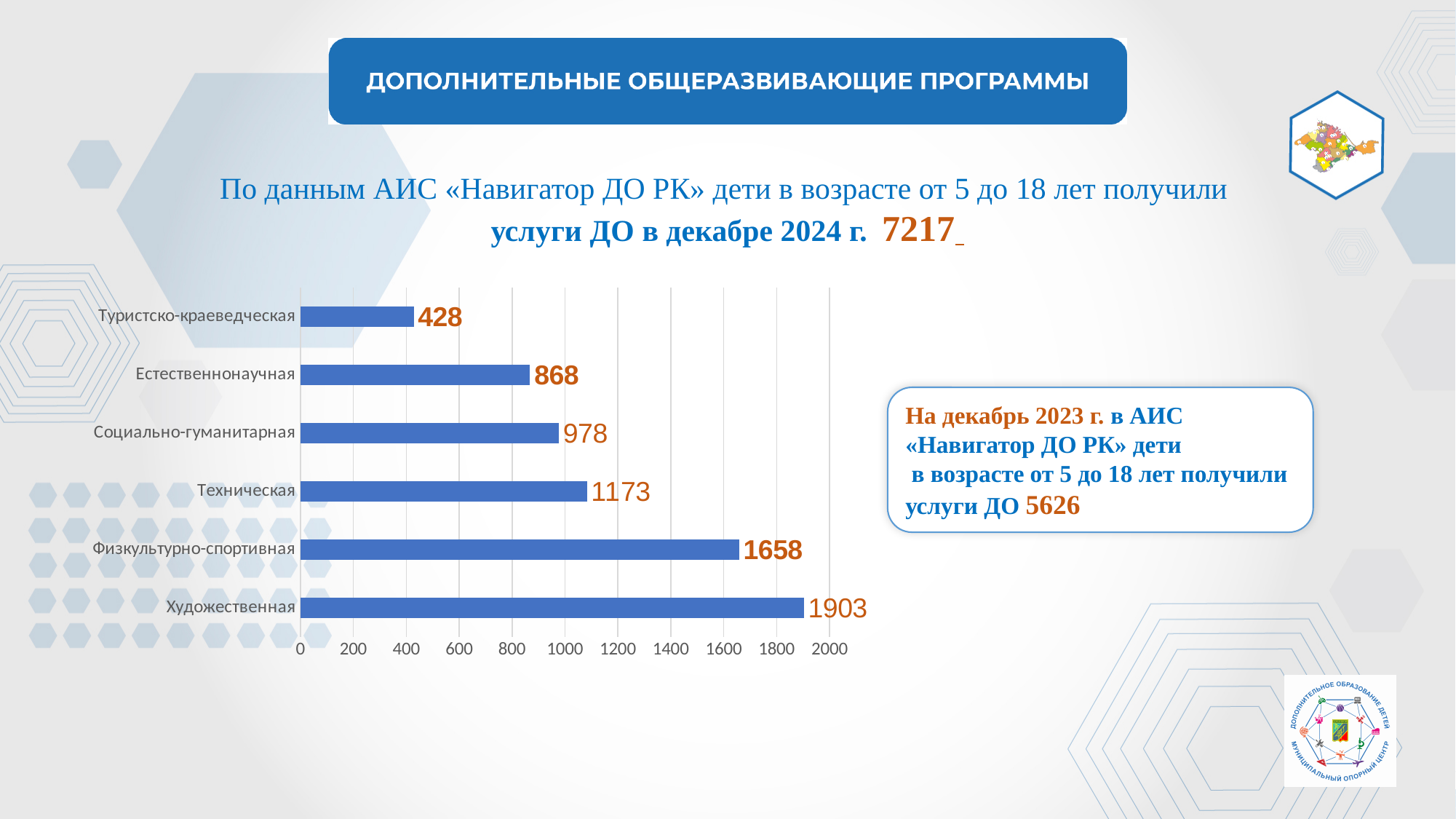
What is the difference between the values for Естественнонаучная and Туристско-краеведческая? 440 What is the value for Туристско-краеведческая? 428 What is the difference between the values for Художественная and Физкультурно-спортивная? 245 What kind of chart is shown on the slide? bar chart What is the value for Техническая? 1173 How many categories are shown in the chart? 6 What is the value for Художественная? 1903 Which category has the lowest value? Туристско-краеведческая What is the value for Социально-гуманитарная? 978 Is the value for Социально-гуманитарная greater or less than 1000? less Which is larger, the value for Физкультурно-спортивная or the value for Техническая? Физкультурно-спортивная Which category has the highest value? Художественная